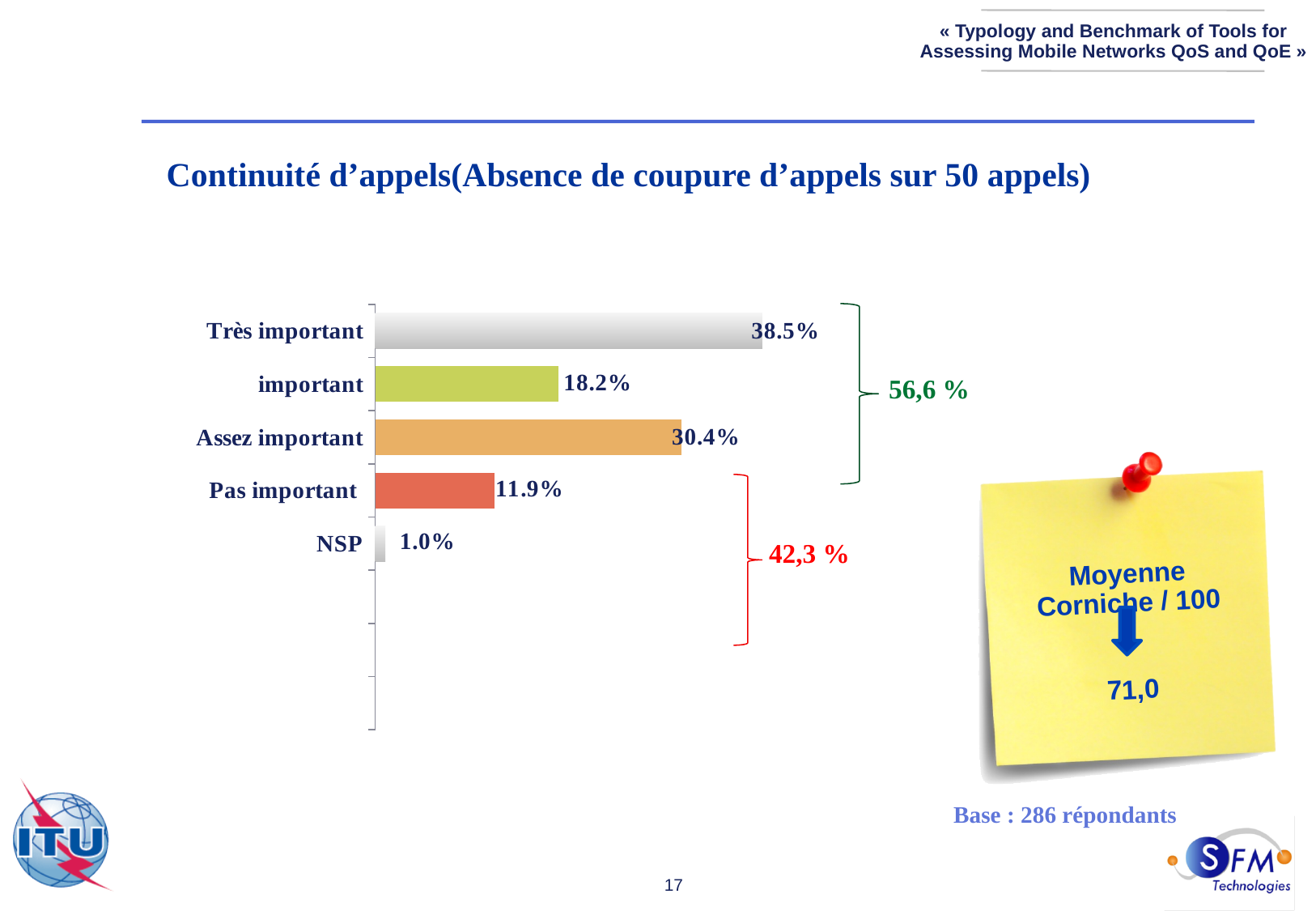
What kind of chart is shown on the slide? Bar chart What is the value for "Assez important"? 30.4% What is the value for "Pas important"? 11.9% What is the difference between the values for "Très important" and "Assez important"? 8.1% Which category has the highest value? Très important Which is larger, the value for "important" or the value for "Pas important"? important What is the value for "important"? 18.2% What is the value for "Très important"? 38.5% What percentage is shown next to the green bracket grouping the top three categories? 56,6 % Which category has the lowest value? NSP How many categories are shown in the chart? 5 What is the value for "NSP"? 1.0%